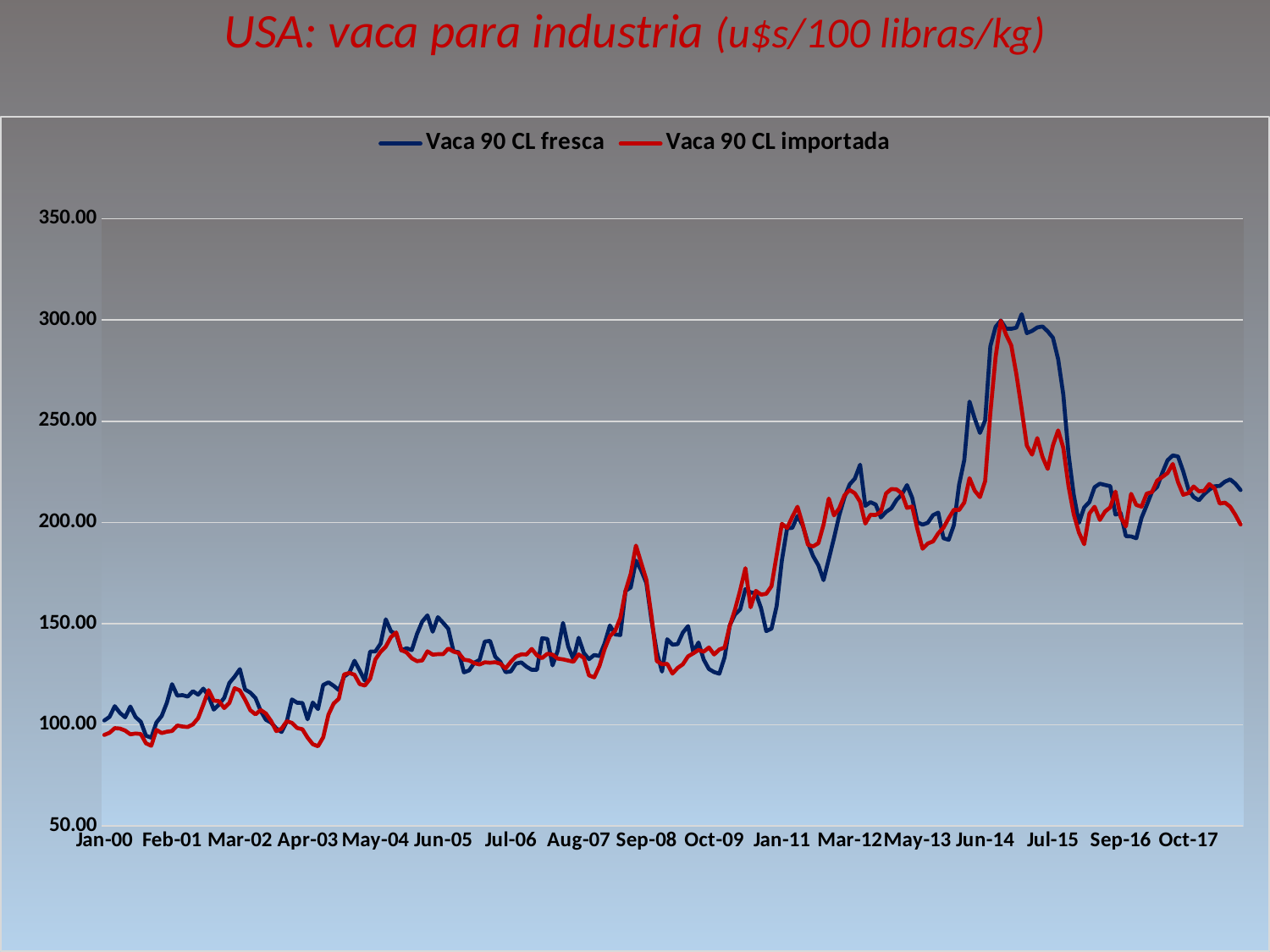
Is the value for Vaca 90 CL importada at Sep-08 greater or less than 150? greater What kind of chart is shown on the slide? line chart At Jul-15, which series has the larger value, Vaca 90 CL fresca or Vaca 90 CL importada? Vaca 90 CL fresca Which colour is used for the Vaca 90 CL importada series? red What is the title of the chart? USA: vaca para industria (u$s/100 libras/kg) Is the value for Vaca 90 CL fresca at Jan-00 greater or less than 150? less Is the peak value of Vaca 90 CL fresca around Jun-14 greater or less than 250? greater Overall, do the values rise or fall from Jan-00 to Oct-17? rise How many date labels are shown on the x axis? 17 How many series does the legend list? 2